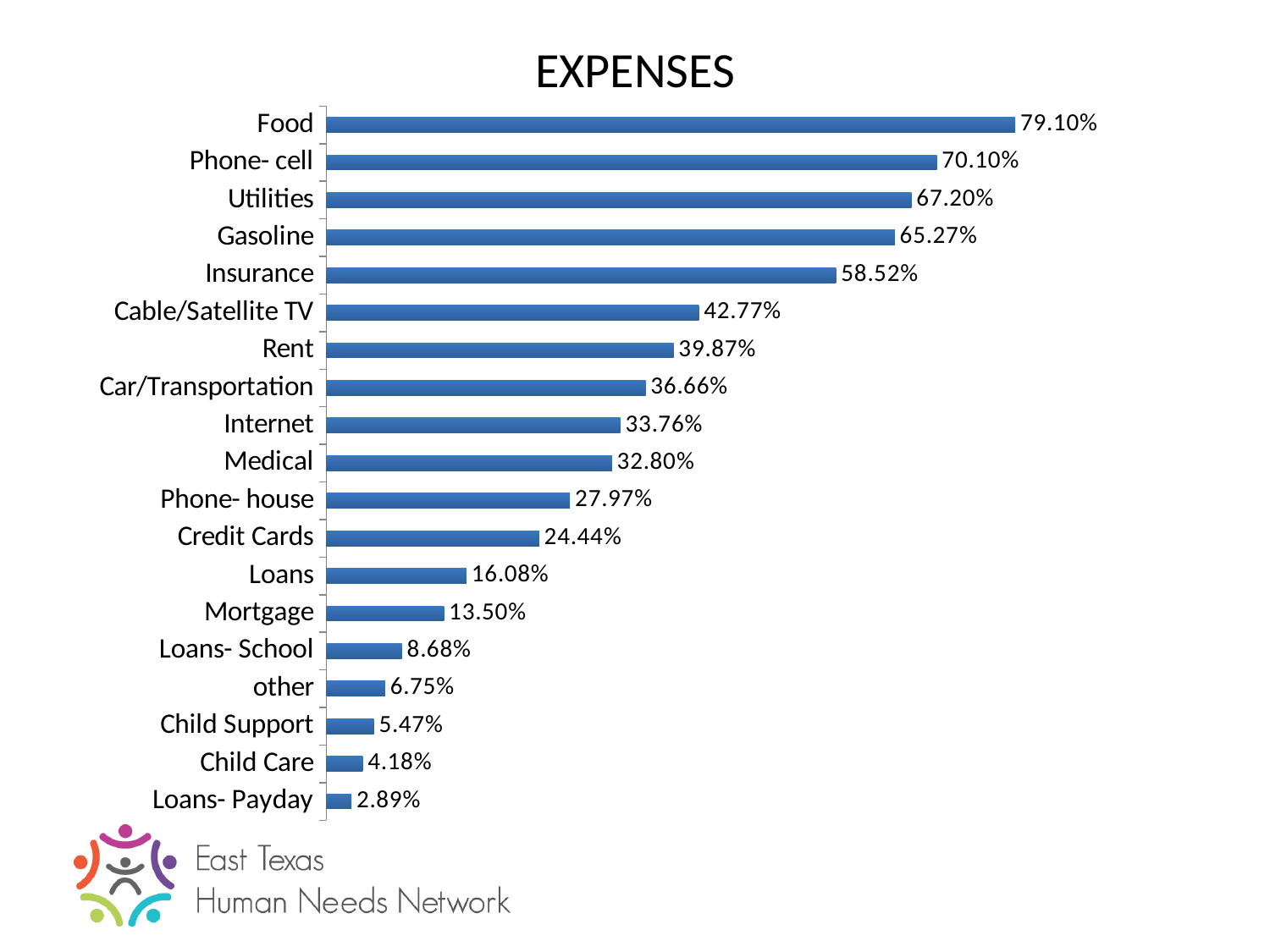
What is the difference between the values for Rent and Car/Transportation? 3.21% Which category has the highest value? Food What is the title of the chart? EXPENSES What is the difference between the values for Food and Phone- cell? 9.00% Which category has the lowest value? Loans- Payday How many categories are shown in the chart? 19 What is the value for Child Care? 4.18% What is the value for Mortgage? 13.50% What kind of chart is shown on the slide? Bar chart Which is larger, the value for Internet or the value for Medical? Internet What is the value for Cable/Satellite TV? 42.77% What is the value for Food? 79.10%